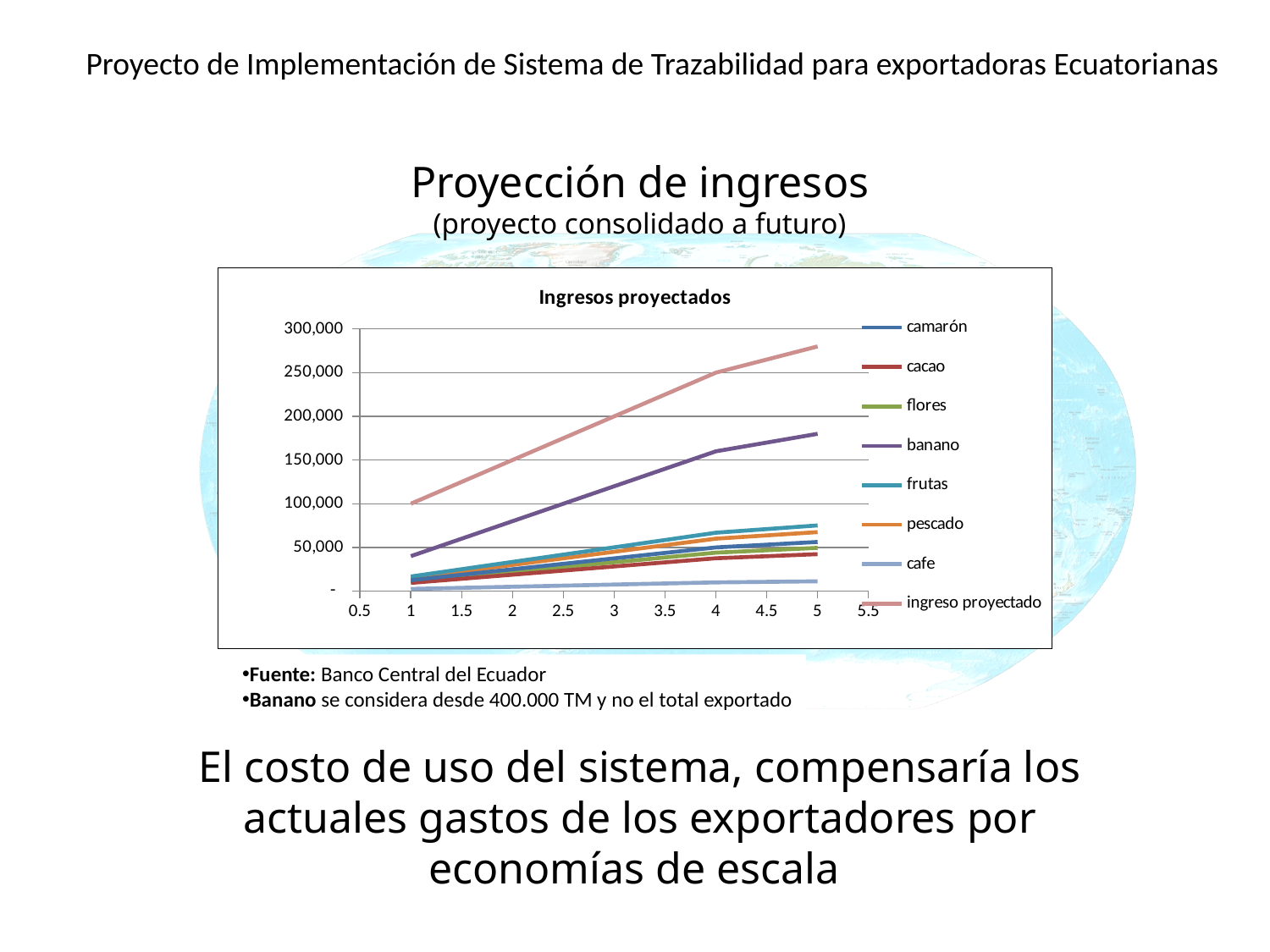
What is the title of the chart? Ingresos proyectados How many data points does each line in the chart have? 5 Is the value for banano at x = 5 greater or less than 150,000? greater Which series has the lowest values on the chart? cafe What kind of chart is shown on the slide? line chart Is the value for cafe at x = 5 greater or less than 50,000? less How many series does the legend of the chart list? 8 Is the value for banano at x = 1 greater or less than 50,000? less Do the values of the ingreso proyectado series rise or fall along the x axis? rise At x = 5, which is larger: banano or frutas? banano Which series reaches the highest value on the chart? ingreso proyectado